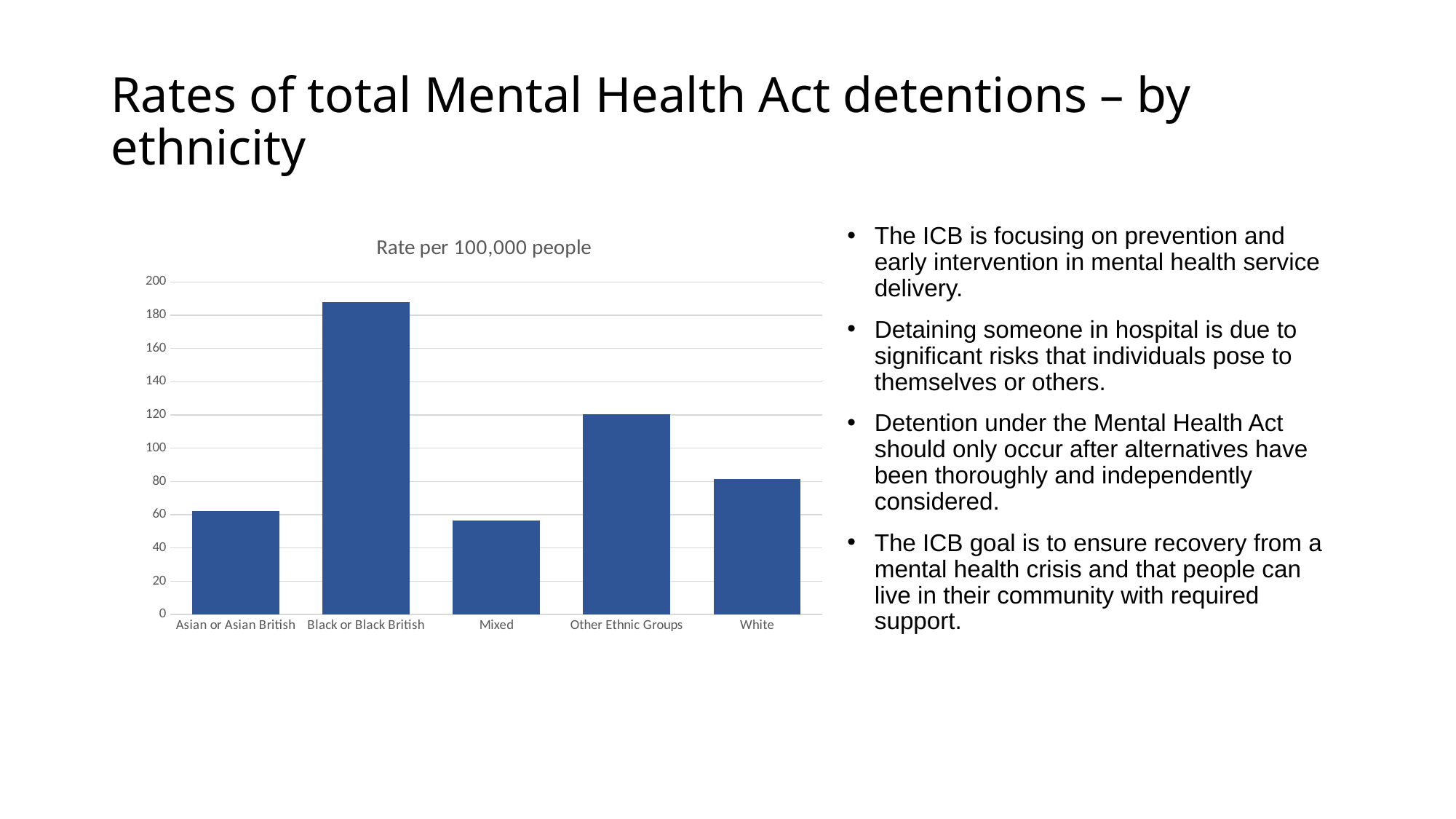
Is the value for Mixed greater or less than 40? greater Which has a higher rate, Other Ethnic Groups or White? Other Ethnic Groups What is the title of the chart? Rate per 100,000 people Which has a higher rate, Asian or Asian British or Black or Black British? Black or Black British Is the value for Asian or Asian British greater or less than 80? less How many ethnic group categories are shown on the chart? 5 Is the value for Black or Black British greater or less than 180? greater Which ethnic group has the highest rate of detentions? Black or Black British Which ethnic group has the lowest rate of detentions? Mixed What kind of chart is shown on the slide? bar chart